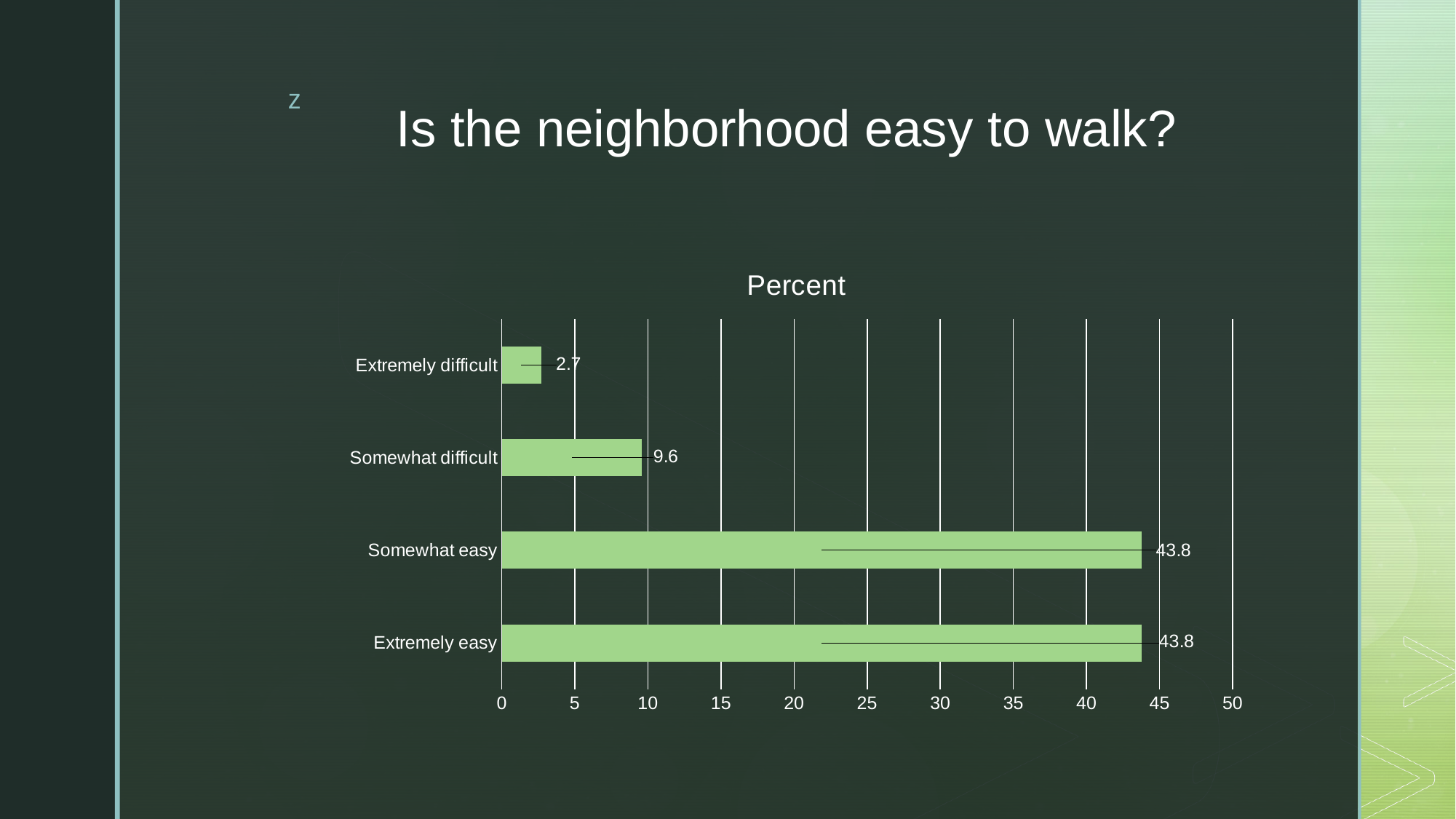
What is the value for Somewhat easy? 43.8 What is the value for Extremely difficult? 2.7 What kind of chart is shown on the slide? bar chart Which category has the lowest value? Extremely difficult What is the difference between the values for Somewhat difficult and Extremely difficult? 6.9 What is the title of the chart? Percent What is the difference between the values for Somewhat easy and Somewhat difficult? 34.2 What is the value for Somewhat difficult? 9.6 Which is larger, the value for Somewhat difficult or the value for Extremely difficult? Somewhat difficult How many categories are shown in the chart? 4 What is the value for Extremely easy? 43.8 Is the value for Somewhat difficult greater or less than 10? less